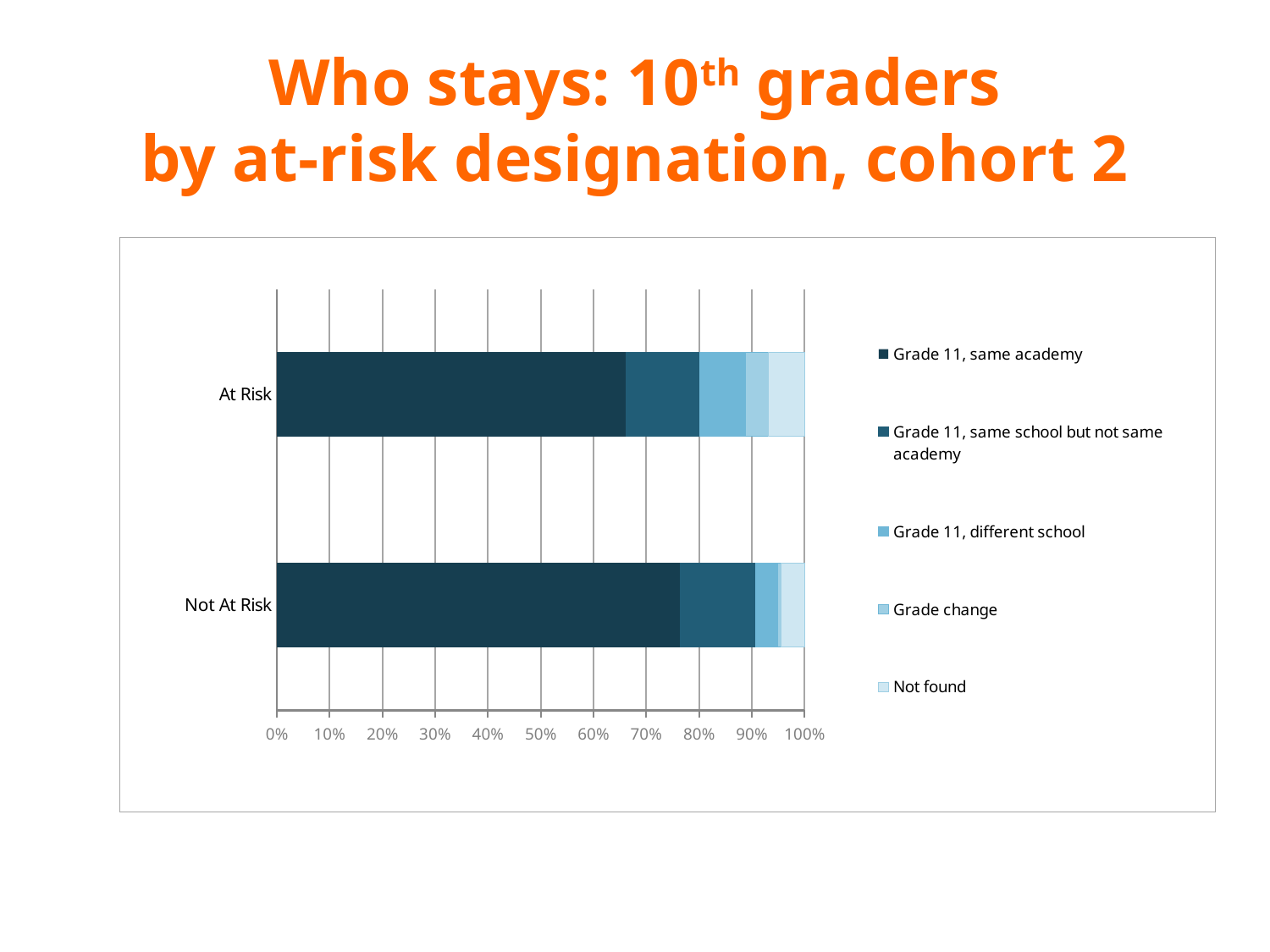
Is the 'Grade 11, same academy' share for At Risk greater or less than 70%? less Is the 'Grade 11, same academy' share for At Risk greater or less than 60%? greater How many categories are shown on the vertical axis of the chart? 2 Which legend entry is shown in the darkest blue colour? Grade 11, same academy Is the 'Grade 11, same academy' share for Not At Risk greater or less than 70%? greater How many series does the chart legend list? 5 Which series makes up the largest segment of the At Risk bar? Grade 11, same academy Which category has the larger 'Grade 11, same academy' share, At Risk or Not At Risk? Not At Risk What kind of chart is shown on the slide? Stacked bar chart What is the title of the slide containing the chart? Who stays: 10th graders by at-risk designation, cohort 2 Which category has the larger 'Grade 11, different school' share, At Risk or Not At Risk? At Risk